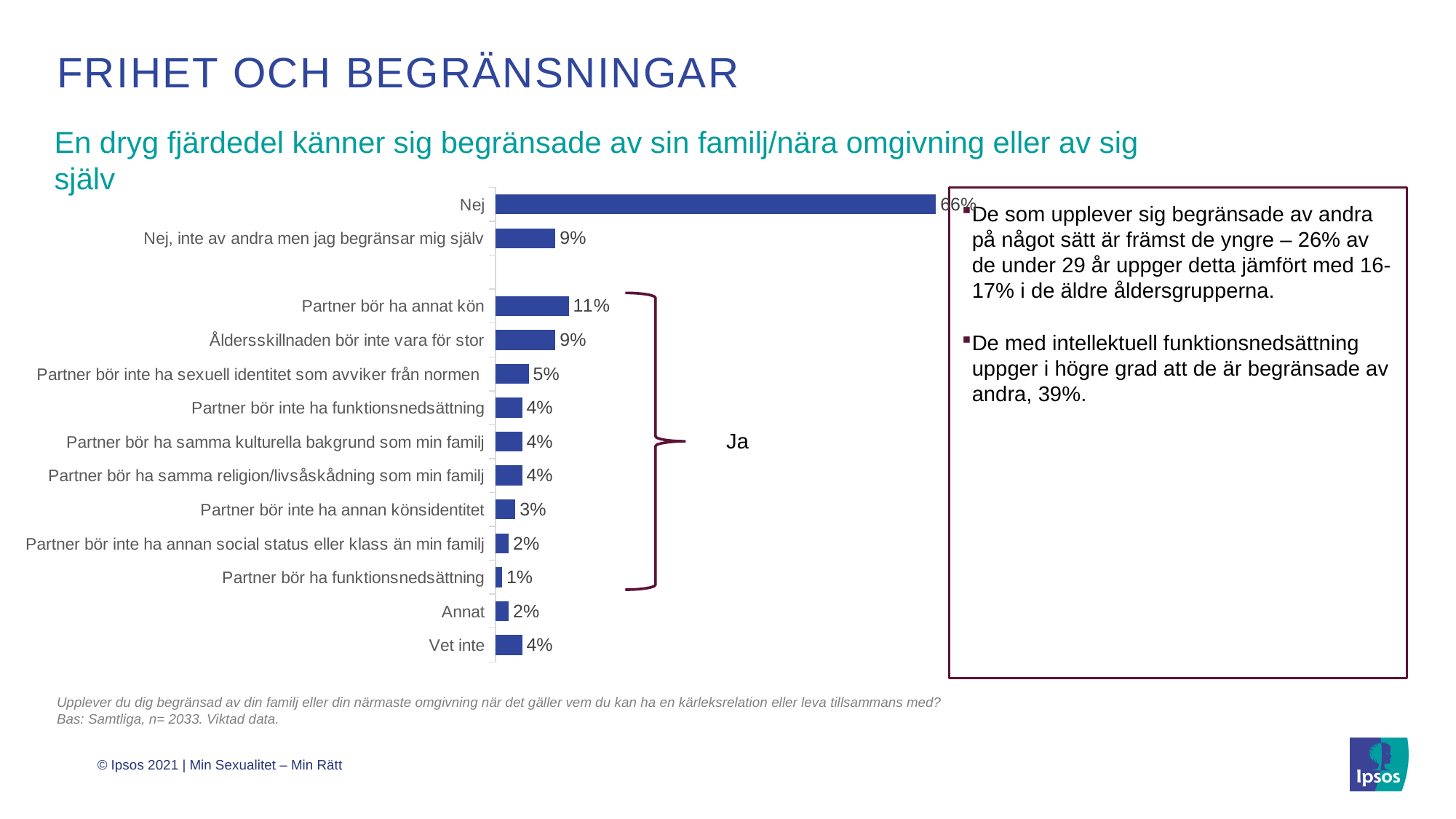
What is the value for "Partner bör ha funktionsnedsättning"? 1% What is the difference between the values for "Partner bör ha annat kön" and "Partner bör inte ha sexuell identitet som avviker från normen"? 6% What is the value for "Nej"? 66% What is the value for "Åldersskillnaden bör inte vara för stor"? 9% Which is larger, the value for "Partner bör inte ha annan könsidentitet" or the value for "Partner bör inte ha annan social status eller klass än min familj"? Partner bör inte ha annan könsidentitet How many categories are shown in the chart? 13 What is the value for "Vet inte"? 4% Which category has the lowest value? Partner bör ha funktionsnedsättning What kind of chart is shown on the slide? Bar chart Which category has the highest value? Nej What is the value for "Partner bör ha annat kön"? 11% What is the difference between the values for "Nej" and "Partner bör ha annat kön"? 55%